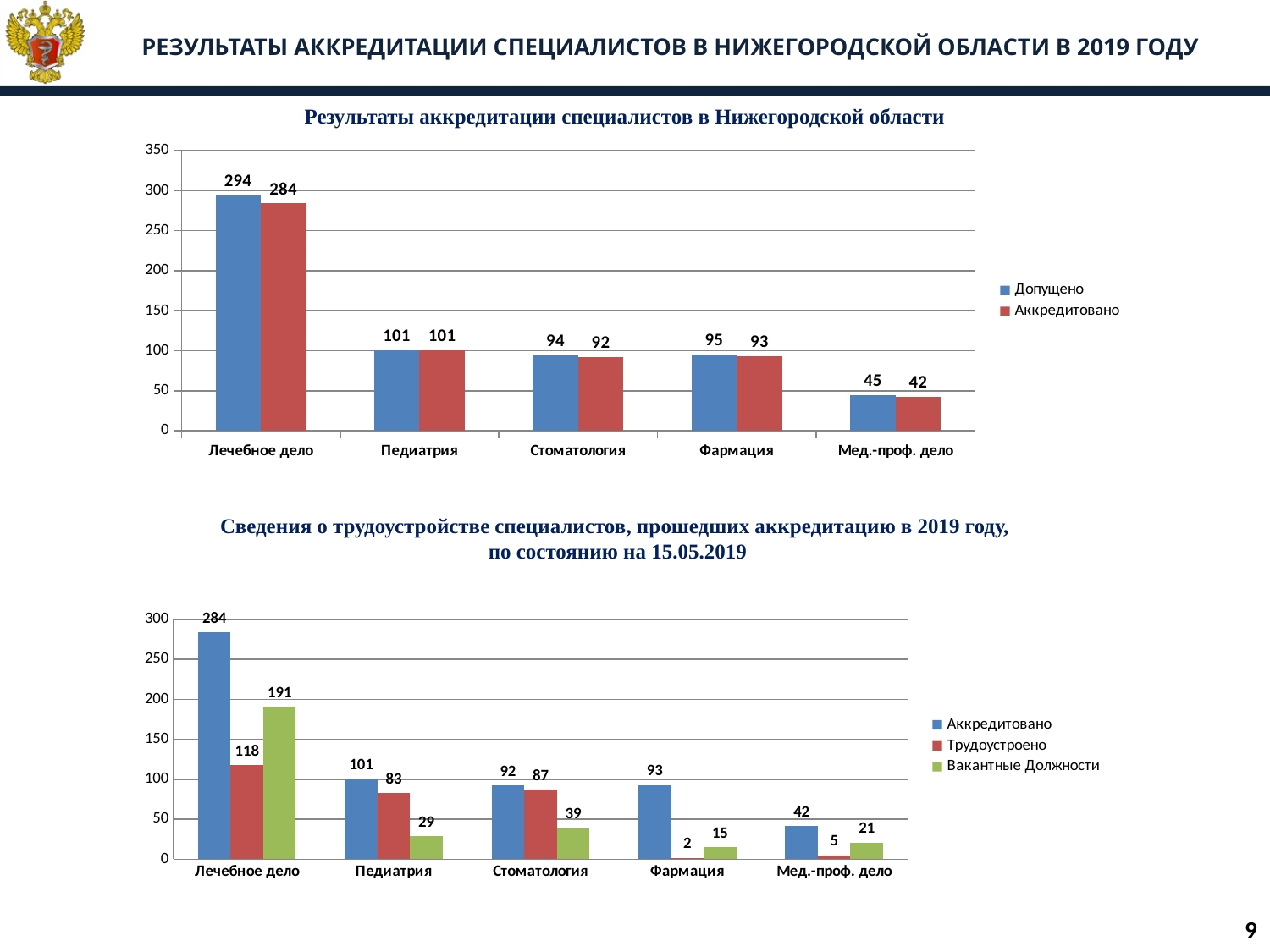
In the top chart 'Результаты аккредитации специалистов в Нижегородской области', what is the 'Допущено' value for Лечебное дело? 294 In the top chart, how many categories are shown on the x axis? 5 In the bottom chart, what is the 'Вакантные Должности' value for Лечебное дело? 191 In the top chart, how many series does the legend list? 2 In the top chart, which category has the lowest 'Допущено' value? Мед.-проф. дело In the bottom chart, which category has the highest 'Вакантные Должности' value? Лечебное дело In the bottom chart, which is larger for Педиатрия: 'Трудоустроено' or 'Вакантные Должности'? Трудоустроено In the bottom chart 'Сведения о трудоустройстве специалистов', what is the 'Трудоустроено' value for Фармация? 2 In the bottom chart, what is the difference between 'Аккредитовано' and 'Трудоустроено' for Стоматология? 5 In the top chart, what is the difference between 'Допущено' and 'Аккредитовано' for Лечебное дело? 10 In the top chart, what is the 'Аккредитовано' value for Стоматология? 92 What type of chart is the bottom chart? Bar chart